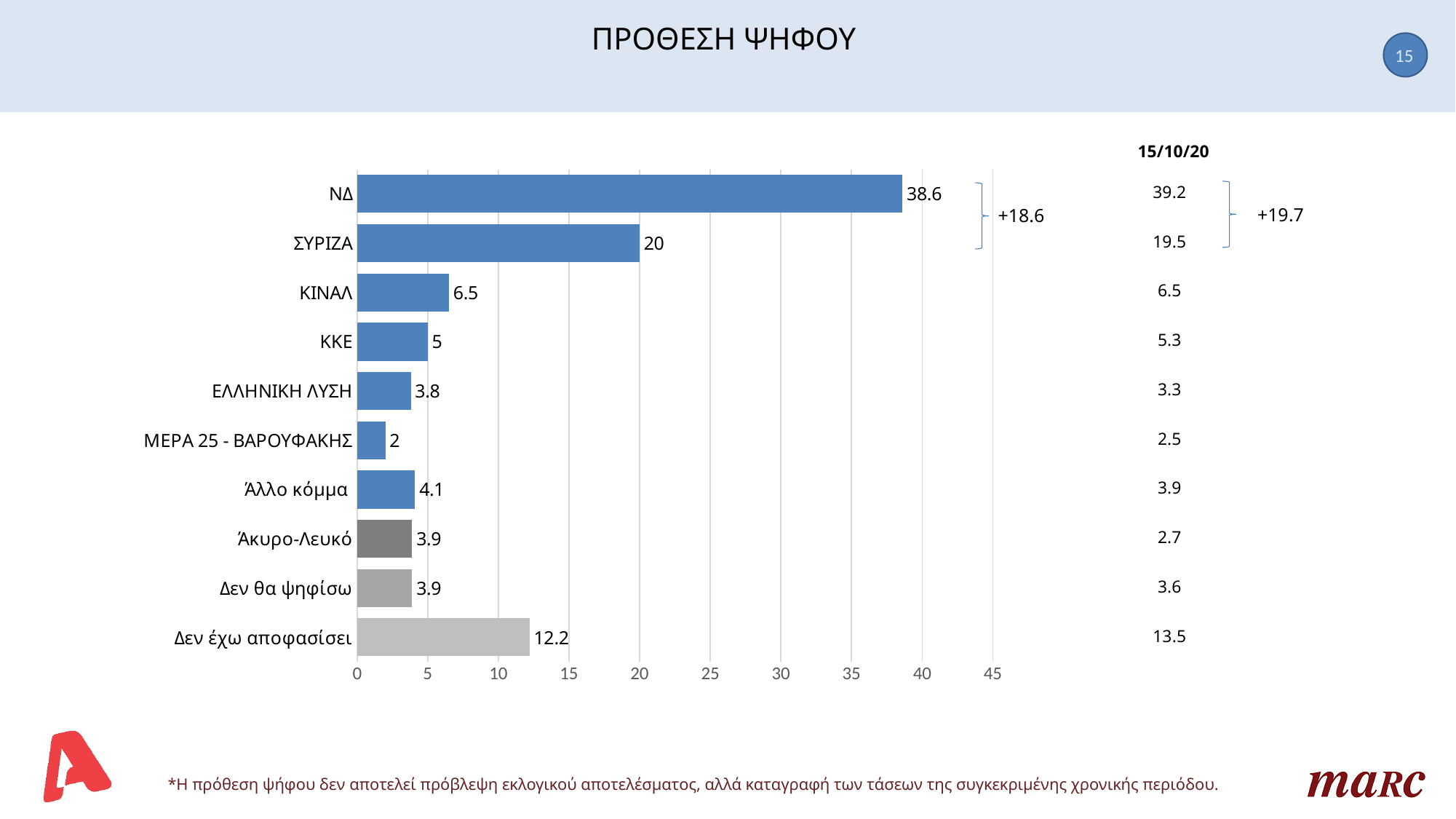
Which category has the highest value? ΝΔ What is the title of the slide? ΠΡΟΘΕΣΗ ΨΗΦΟΥ What is the difference between the values for ΝΔ and ΣΥΡΙΖΑ? 18.6 How many categories are shown in the chart? 10 Is the value for ΣΥΡΙΖΑ greater or less than 25? less What is the value for ΝΔ? 38.6 Which is larger, the value for ΚΚΕ or the value for ΕΛΛΗΝΙΚΗ ΛΥΣΗ? ΚΚΕ What is the value for Δεν έχω αποφασίσει? 12.2 What is the value for ΣΥΡΙΖΑ? 20 What is the value for ΚΙΝΑΛ? 6.5 What kind of chart is shown on the slide? bar chart Which category has the lowest value? ΜΕΡΑ 25 - ΒΑΡΟΥΦΑΚΗΣ